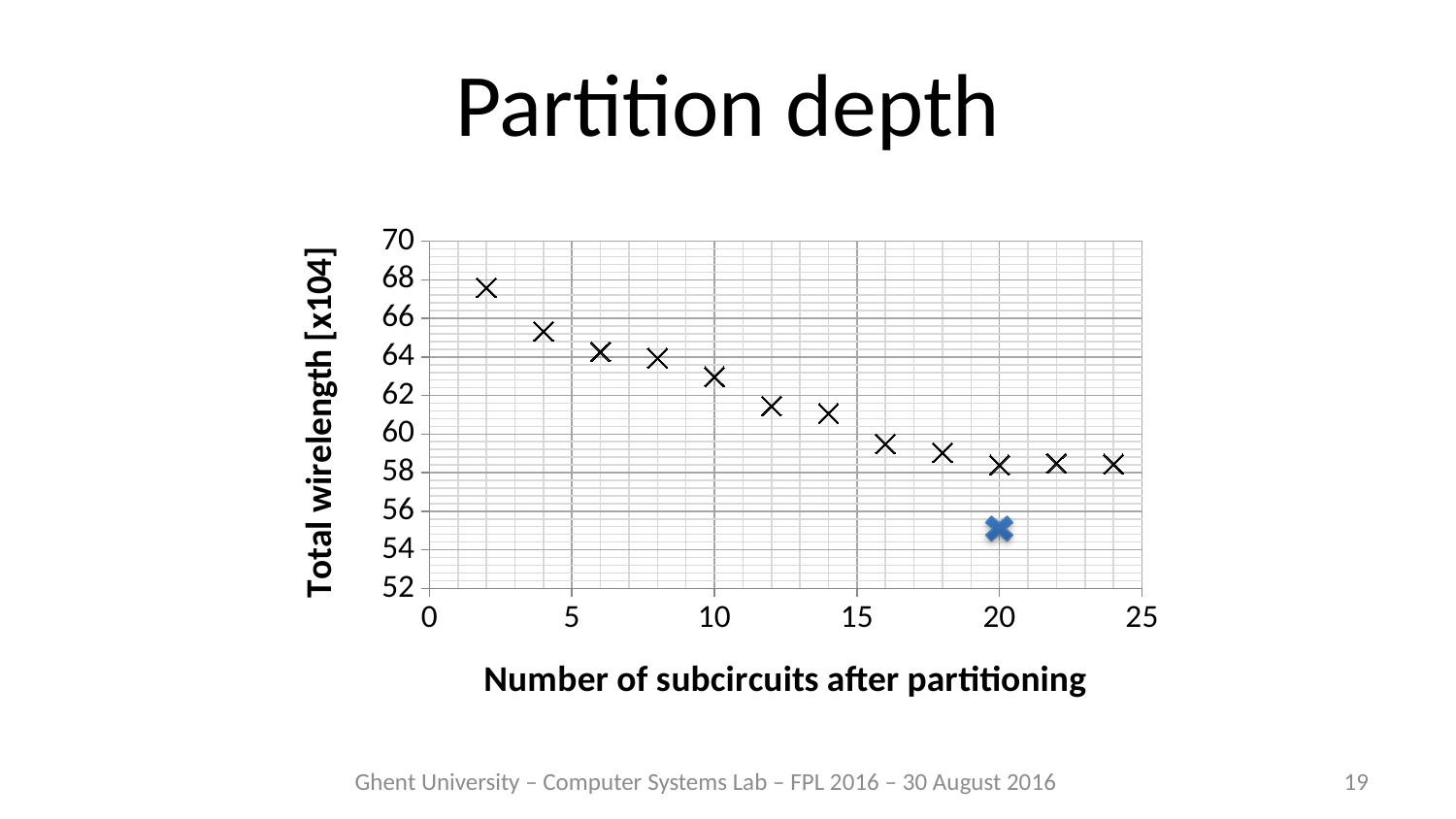
Is the total wirelength at 24 subcircuits greater or less than 60? less Is the total wirelength at 10 subcircuits greater or less than 62? greater Which has the larger total wirelength: 4 subcircuits or 12 subcircuits? 4 subcircuits Is the total wirelength at 2 subcircuits greater or less than 66? greater Do the black data points rise or fall as the number of subcircuits increases? fall What kind of chart is shown on the slide? scatter chart Which point has the lowest total wirelength on the chart? the blue marker at 20 subcircuits What is the title of the x axis? Number of subcircuits after partitioning At which number of subcircuits is the total wirelength highest? 2 What is the title of the y axis? Total wirelength [x104] How many black x markers are plotted on the chart? 12